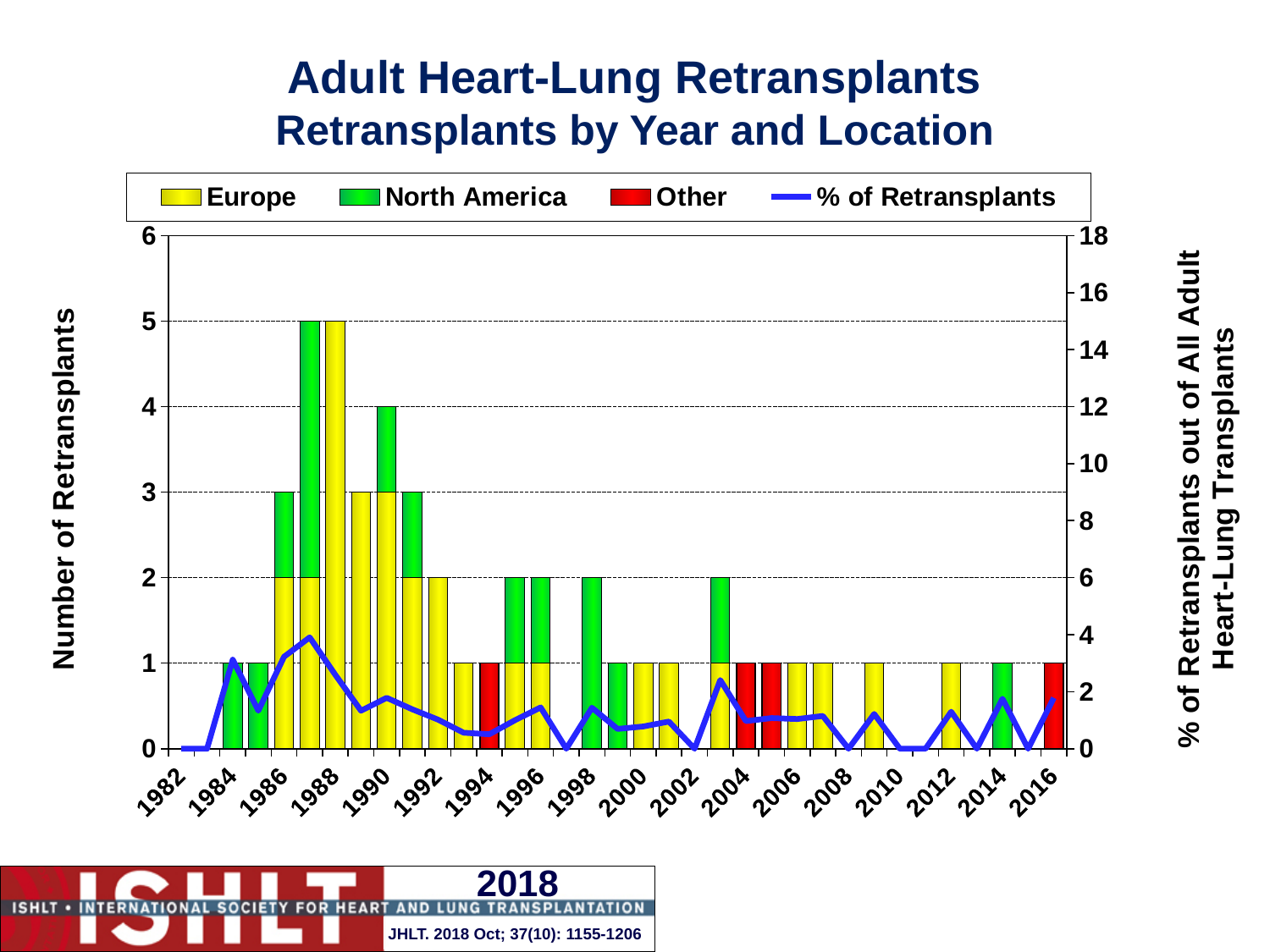
Which location category is shown in red? Other Is the % of Retransplants value for 1987 greater or less than 2? greater Which year has more retransplants, 1990 or 1992? 1990 Which series is plotted as a line rather than bars? % of Retransplants What is the total number of retransplants in 1990? 4 What is the difference in the number of retransplants between 1988 and 1992? 3 What is the highest number of retransplants recorded in any single year? 5 From 1984 to 1987, does the number of retransplants rise or fall? rise What is the total number of retransplants in 1988? 5 How many series does the legend list? 4 What kind of chart is shown on the slide? bar chart with a line What is the total height of the stacked bar for 1986? 3